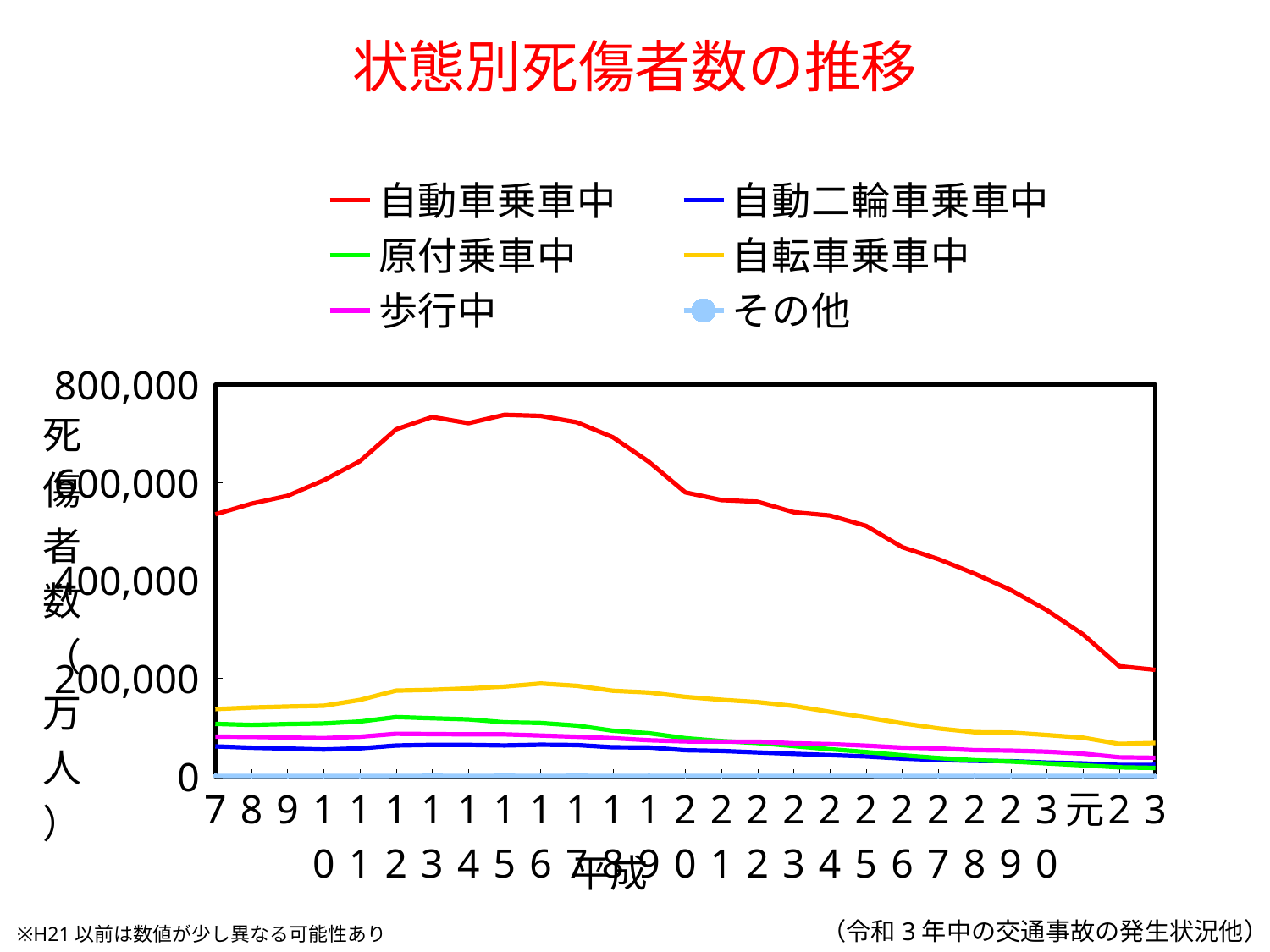
Is the value for 自動車乗車中 in 令和3 greater or less than 400,000? less Is the value for 自転車乗車中 in 平成7 greater or less than 200,000? less Which series is drawn in red? 自動車乗車中 Is the peak value of 自動車乗車中 greater or less than 600,000? greater Which series has the lowest values across the whole period? その他 Does the value for 自動車乗車中 rise or fall from 平成20 to 令和3? fall How many series does the legend list? 6 Which series has the highest values across the whole period? 自動車乗車中 Which is larger in 平成7, the value for 自転車乗車中 or the value for 原付乗車中? 自転車乗車中 What is the title of the chart? 状態別死傷者数の推移 What kind of chart is shown on the slide? line chart